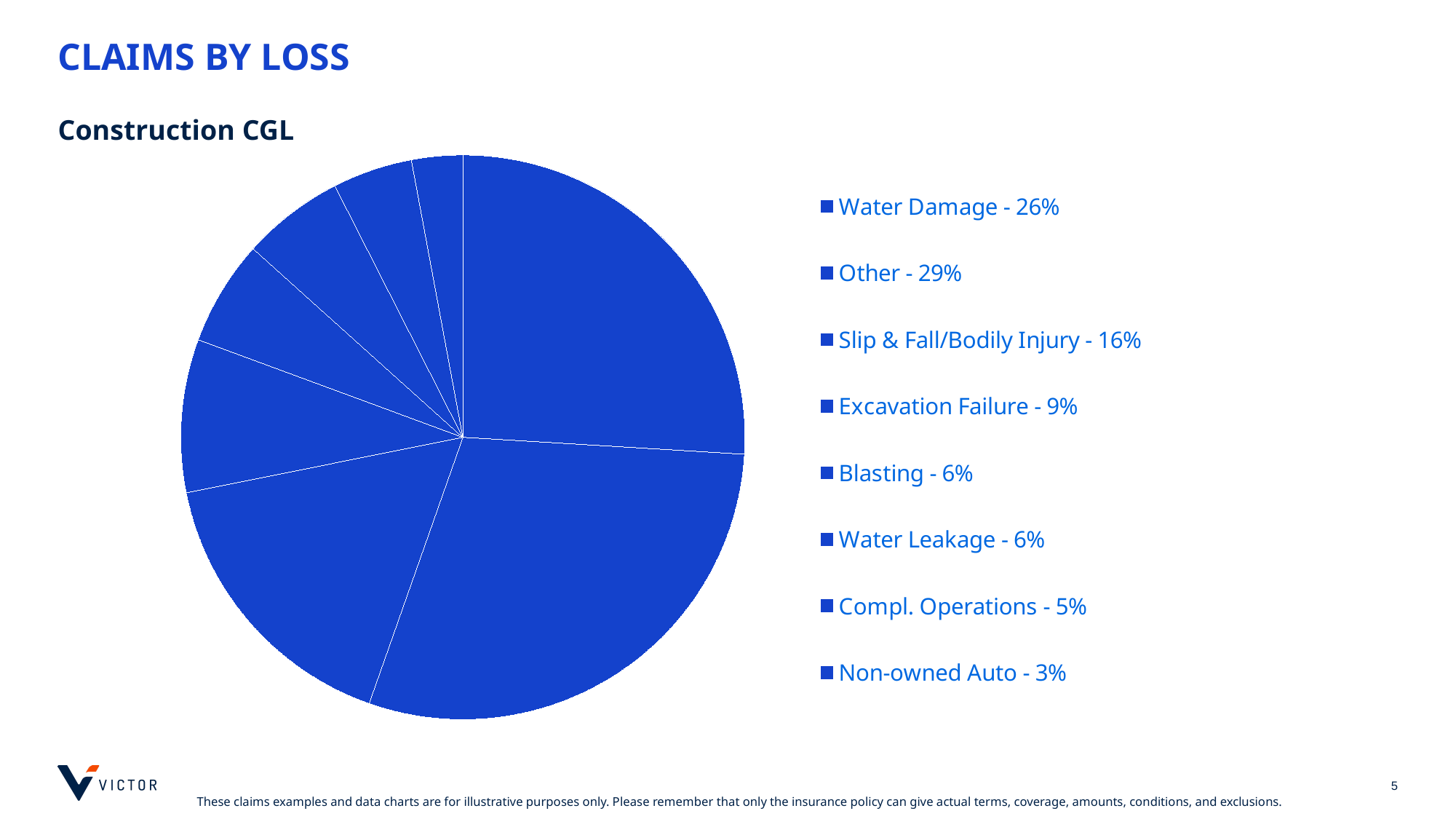
What is the subtitle shown above the pie chart? Construction CGL Which loss category has the smallest share of claims? Non-owned Auto What kind of chart is shown on the slide? pie chart Which loss category has the largest share of claims? Other What percentage is shown for Compl. Operations? 5% What is the combined share of Blasting and Water Leakage? 12% What is the difference in percentage points between Other and Water Damage? 3 percentage points Which has a larger share, Slip & Fall/Bodily Injury or Excavation Failure? Slip & Fall/Bodily Injury What percentage is shown for Excavation Failure? 9% What percentage is shown for Slip & Fall/Bodily Injury? 16% What share of claims is attributed to Water Damage? 26% How many loss categories does the pie chart show? 8